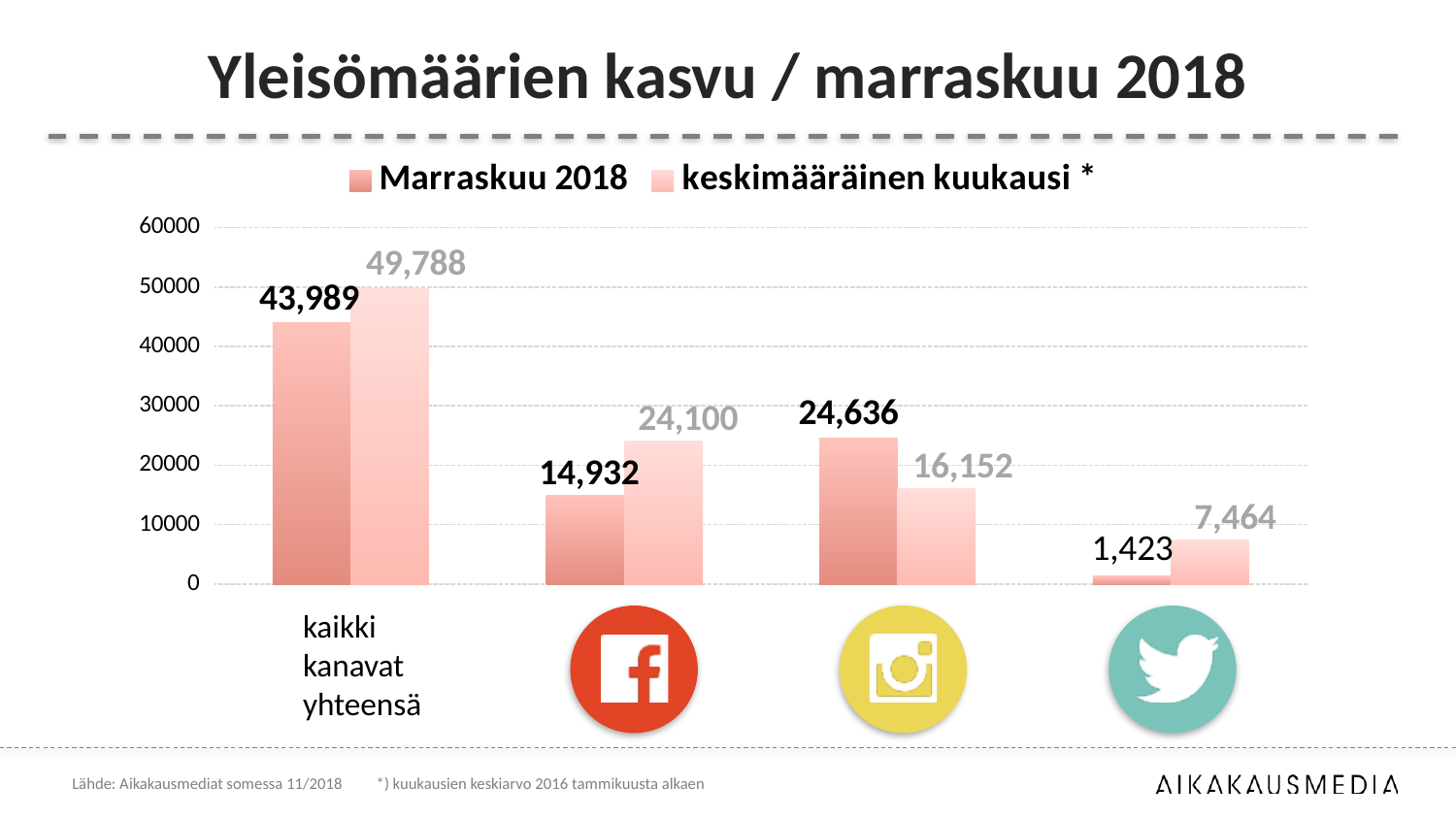
How many series does the legend list? 2 What is the keskimääräinen kuukausi value for the Instagram category? 16,152 For the Instagram category, which is larger: the Marraskuu 2018 value or the keskimääräinen kuukausi value? Marraskuu 2018 What kind of chart is shown on the slide? Bar chart What is the value for Marraskuu 2018 in the 'kaikki kanavat yhteensä' category? 43,989 What is the Marraskuu 2018 value for the Facebook category? 14,932 What is the difference between the keskimääräinen kuukausi value and the Marraskuu 2018 value for the Facebook category? 9,168 What is the Marraskuu 2018 value for the Twitter category? 1,423 What is the value for keskimääräinen kuukausi in the 'kaikki kanavat yhteensä' category? 49,788 Is the keskimääräinen kuukausi value for the Twitter category greater or less than 10000? less What is the title of the slide? Yleisömäärien kasvu / marraskuu 2018 Which category has the lowest Marraskuu 2018 value? Twitter